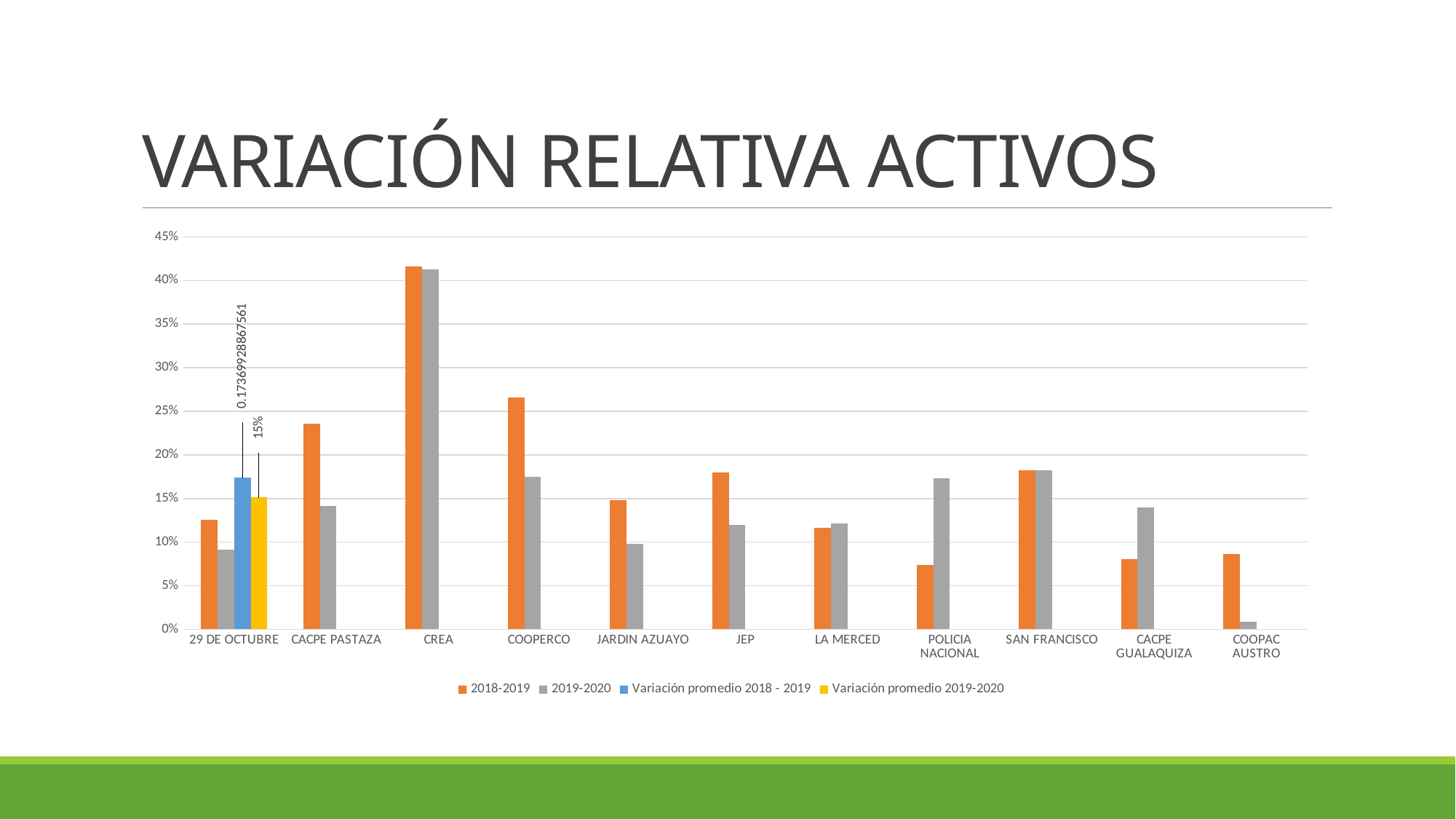
What is the title of the chart? VARIACIÓN RELATIVA ACTIVOS For POLICIA NACIONAL, which is larger: the 2018-2019 value or the 2019-2020 value? 2019-2020 What type of chart is shown on the slide? Bar chart Which category has the lowest 2019-2020 value? COOPAC AUSTRO What value is labelled on the Variación promedio 2019-2020 bar? 15% Is the 2018-2019 value for CREA greater or less than 40%? greater What value is labelled on the Variación promedio 2018 - 2019 bar? 0.17369928867561 Which category has the highest 2018-2019 value? CREA Is the 2019-2020 value for COOPAC AUSTRO greater or less than 5%? less For COOPERCO, which is larger: the 2018-2019 value or the 2019-2020 value? 2018-2019 How many categories are shown on the x axis? 11 How many series does the legend list? 4